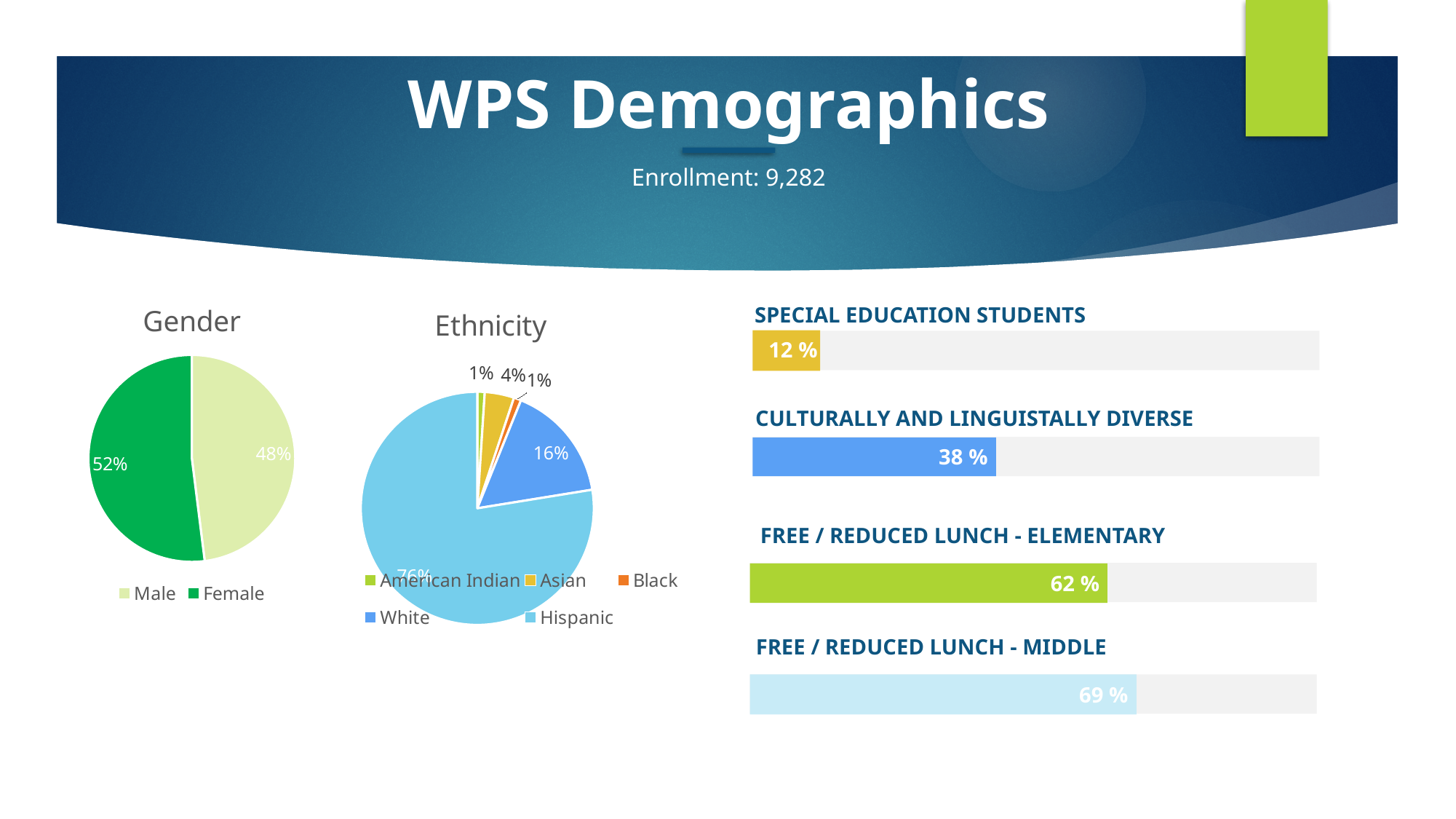
In the Ethnicity chart, which is larger, the Asian share or the White share? White In the Gender chart, what is the difference between the Female and Male shares? 4% In the Gender chart, what percentage is Female? 52% In the Ethnicity chart, which category has the largest share? Hispanic In the Ethnicity chart, what percentage is White? 16% In the Ethnicity chart, what is the difference between the Hispanic and White shares? 60% What kind of chart is the Gender chart? Pie chart In the Ethnicity chart, what percentage is Hispanic? 76% In the Gender chart, what percentage is Male? 48% In the Gender chart, which category has the larger share? Female In the Ethnicity chart, what percentage is Asian? 4% In the Ethnicity chart, how many categories does the legend list? 5